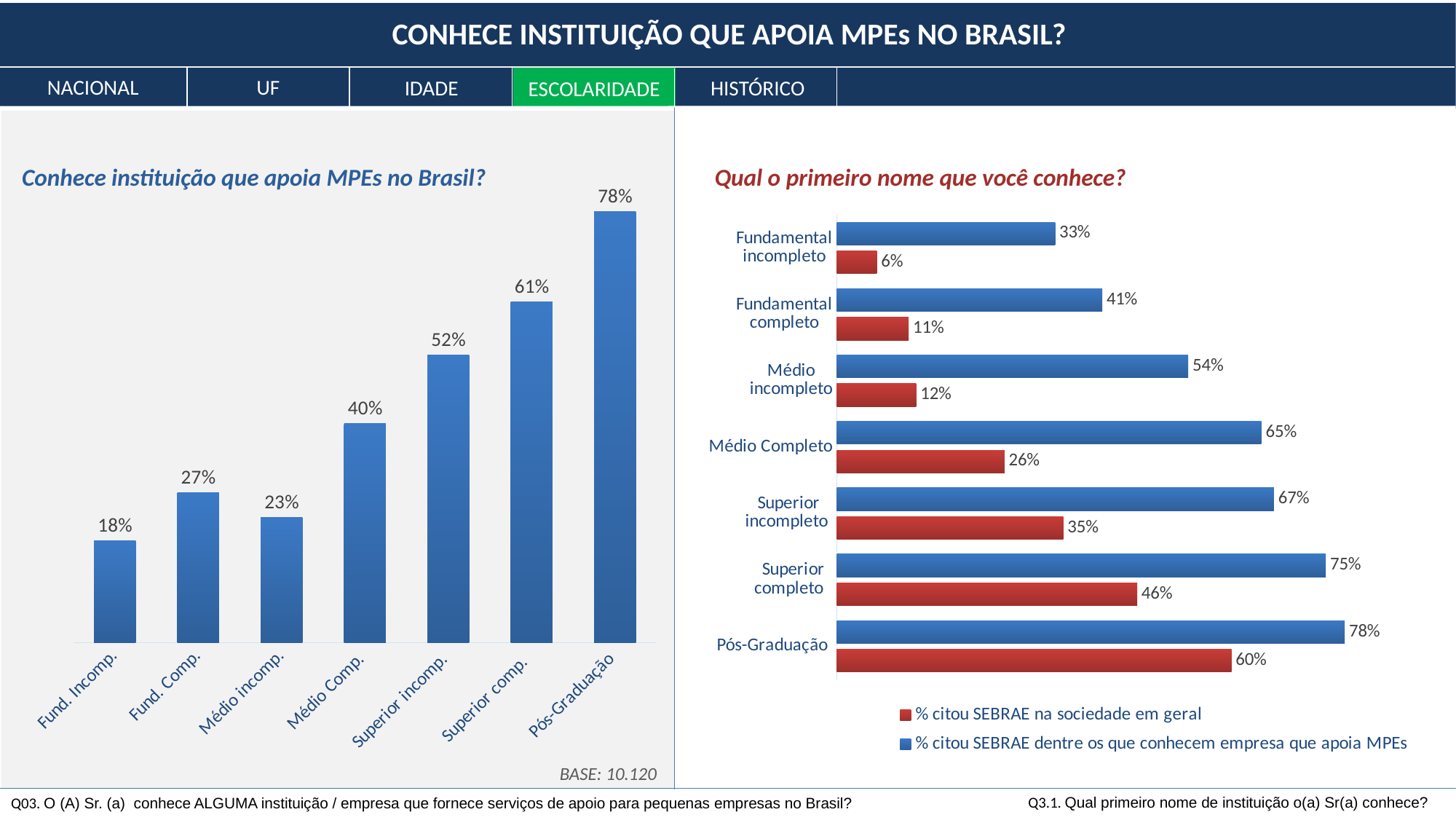
In the right chart 'Qual o primeiro nome que você conhece?', what is the difference between the two series for Superior completo? 29% What kind of chart is the right chart 'Qual o primeiro nome que você conhece?'? Bar chart In the right chart 'Qual o primeiro nome que você conhece?', what is the value of '% citou SEBRAE na sociedade em geral' for Médio Completo? 26% In the left chart 'Conhece instituição que apoia MPEs no Brasil?', what is the value for Pós-Graduação? 78% How many series does the legend of the right chart 'Qual o primeiro nome que você conhece?' list? 2 In the right chart 'Qual o primeiro nome que você conhece?', which category has the highest value for '% citou SEBRAE na sociedade em geral'? Pós-Graduação In the left chart 'Conhece instituição que apoia MPEs no Brasil?', what is the difference between Superior comp. and Superior incomp.? 9% In the right chart 'Qual o primeiro nome que você conhece?', what colour are the bars for '% citou SEBRAE na sociedade em geral'? Red In the left chart 'Conhece instituição que apoia MPEs no Brasil?', which category has the lowest value? Fund. Incomp. In the right chart 'Qual o primeiro nome que você conhece?', what is the value of '% citou SEBRAE dentre os que conhecem empresa que apoia MPEs' for Fundamental completo? 41% In the left chart 'Conhece instituição que apoia MPEs no Brasil?', how many categories are shown? 7 In the left chart 'Conhece instituição que apoia MPEs no Brasil?', which is larger, Fund. Comp. or Médio incomp.? Fund. Comp.